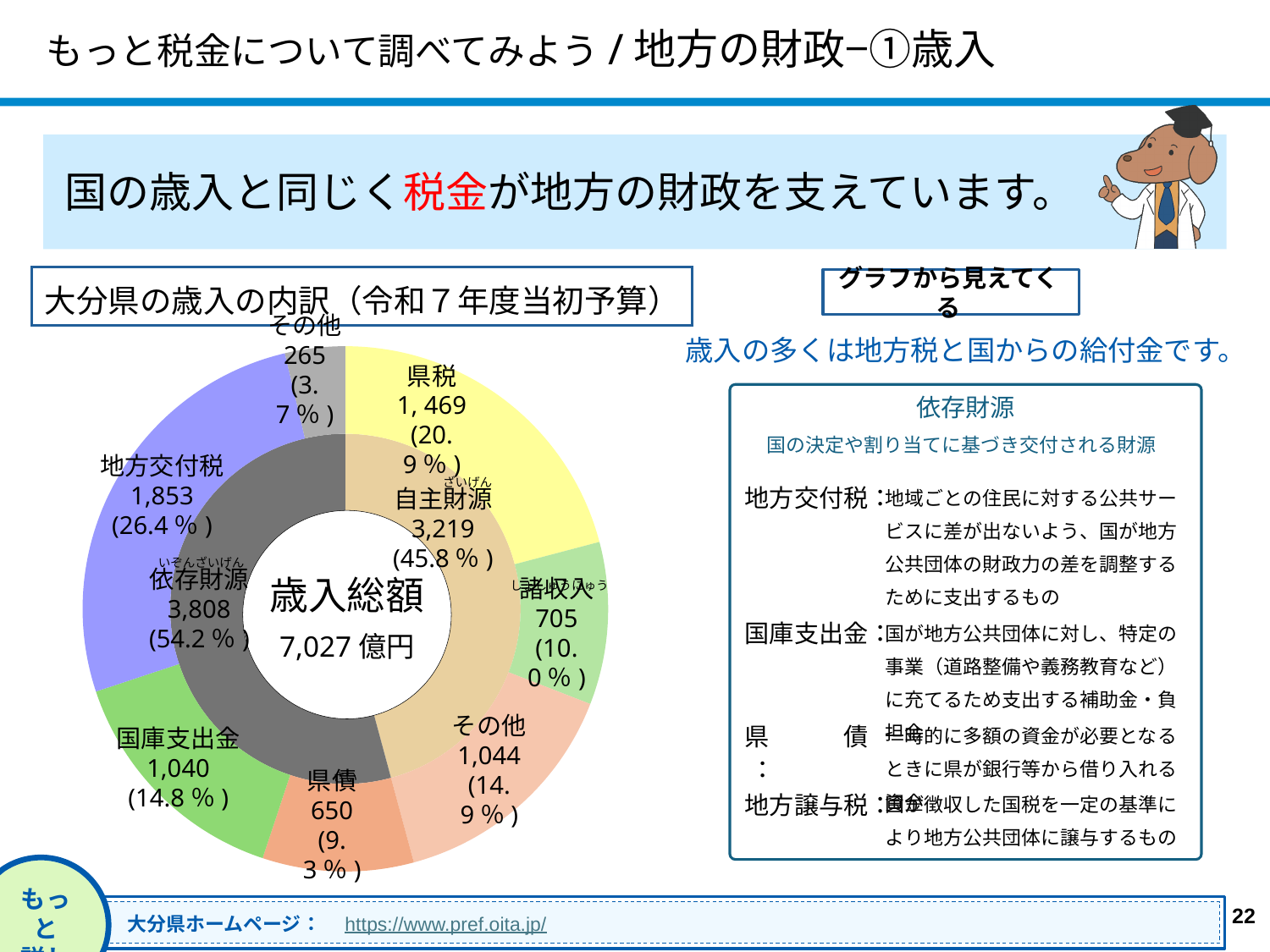
Which of the two inner-ring categories, 自主財源 or 依存財源, is larger? 依存財源 What is the value for 国庫支出金 in the chart? 1,040 Which outer-ring category has the highest value in the chart? 地方交付税 What percentage share does 県債 have in the chart? 9.3% What is the value for 依存財源 in the inner ring of the chart? 3,808 What is the value for 県税 in the chart? 1,469 What is the value for 諸収入 in the chart? 705 What percentage share does 地方交付税 have in the chart? 26.4% What is the difference between the values for 地方交付税 and 県税? 384 What is the title of the chart? 大分県の歳入の内訳（令和７年度当初予算） What is the total revenue (歳入総額) shown in the centre of the chart? 7,027 億円 What kind of chart is shown on the slide? Doughnut chart